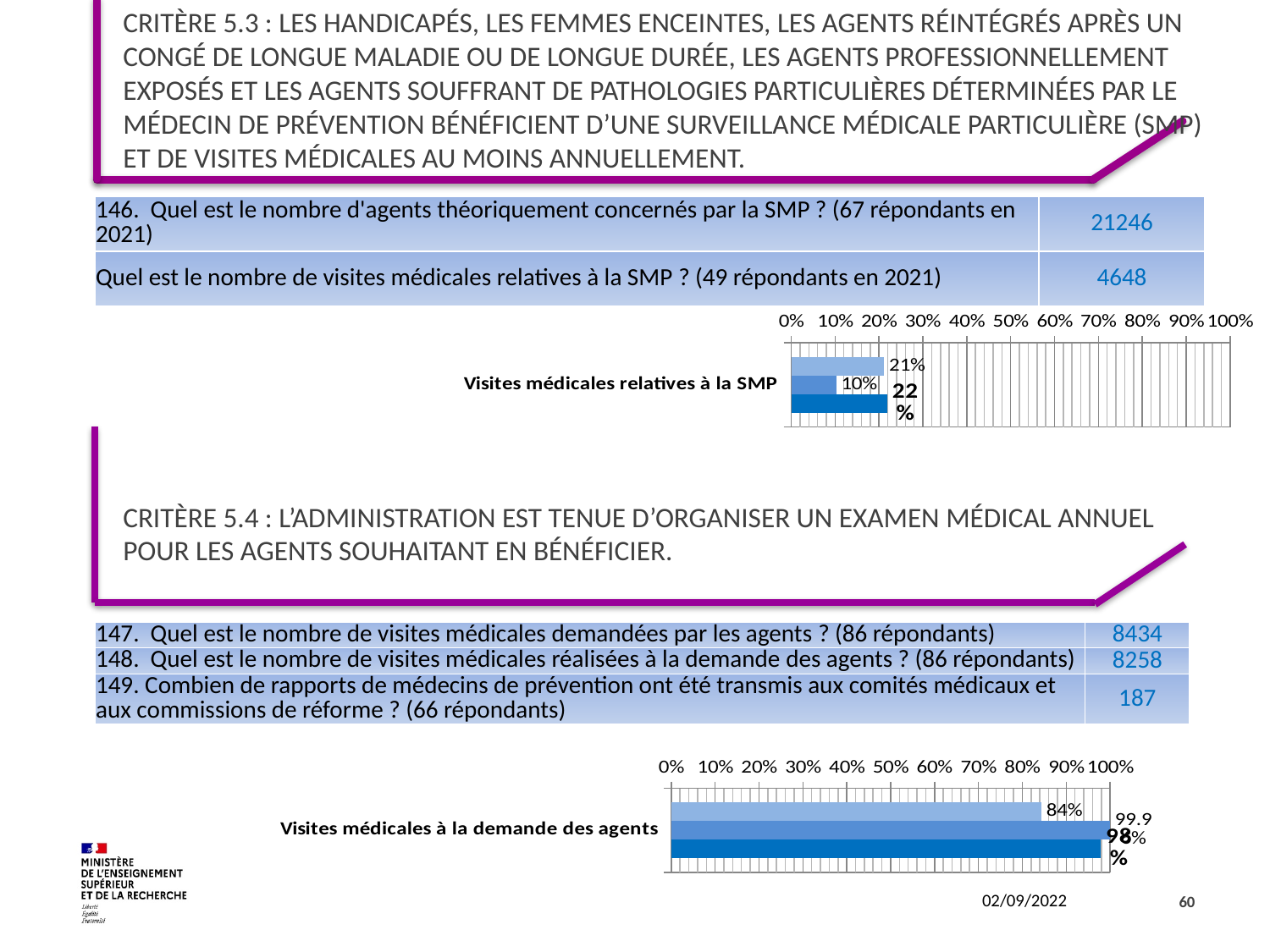
What kind of chart is the chart titled 'Visites médicales relatives à la SMP'? bar chart In the chart 'Visites médicales relatives à la SMP', what value is shown on the top (lightest blue) bar? 21% How many bars are plotted in the chart 'Visites médicales relatives à la SMP'? 3 In the chart 'Visites médicales relatives à la SMP', which bar has the lowest value? the middle bar (10%) In the chart 'Visites médicales à la demande des agents', what value is shown on the bottom (darkest blue) bar? 98% In the chart 'Visites médicales relatives à la SMP', what is the difference between the top bar (21%) and the middle bar (10%)? 11 percentage points In the chart 'Visites médicales à la demande des agents', what value is shown on the top (lightest blue) bar? 84% In the chart 'Visites médicales relatives à la SMP', what value is shown on the bottom (darkest blue) bar? 22% What is the highest value shown on the horizontal axis of the chart 'Visites médicales à la demande des agents'? 100% In the chart 'Visites médicales à la demande des agents', is the value of the top bar greater or less than 90%? less In the chart 'Visites médicales relatives à la SMP', what value is shown on the middle bar? 10% In the chart 'Visites médicales à la demande des agents', which bar has the lowest value? the top bar (84%)